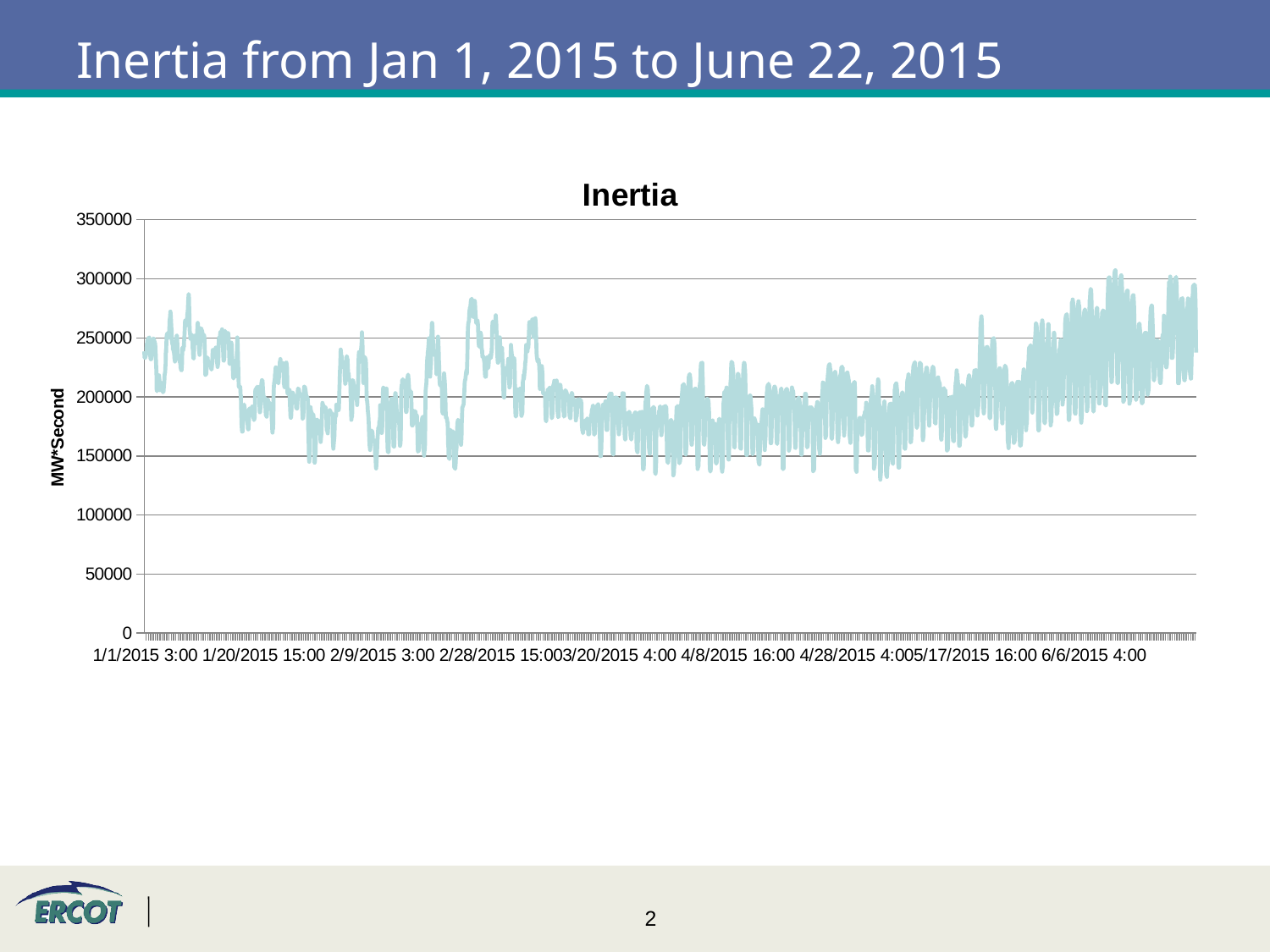
Does the Inertia line ever drop below 100000? No Does the Inertia line generally rise or fall between 4/28/2015 4:00 and 6/6/2015 4:00? rise Does the Inertia line generally rise or fall between 1/1/2015 3:00 and 3/20/2015 4:00? fall Is the value of the Inertia line at 1/1/2015 3:00 greater or less than 200000? greater Is the lowest point of the Inertia line greater or less than 150000? less What is the title of the chart? Inertia How many data series are plotted on the chart? 1 What kind of chart is shown on the slide? line chart What is the highest value shown on the vertical axis? 350000 How many tick labels are shown on the vertical axis? 8 What is the label on the vertical axis of the chart? MW*Second